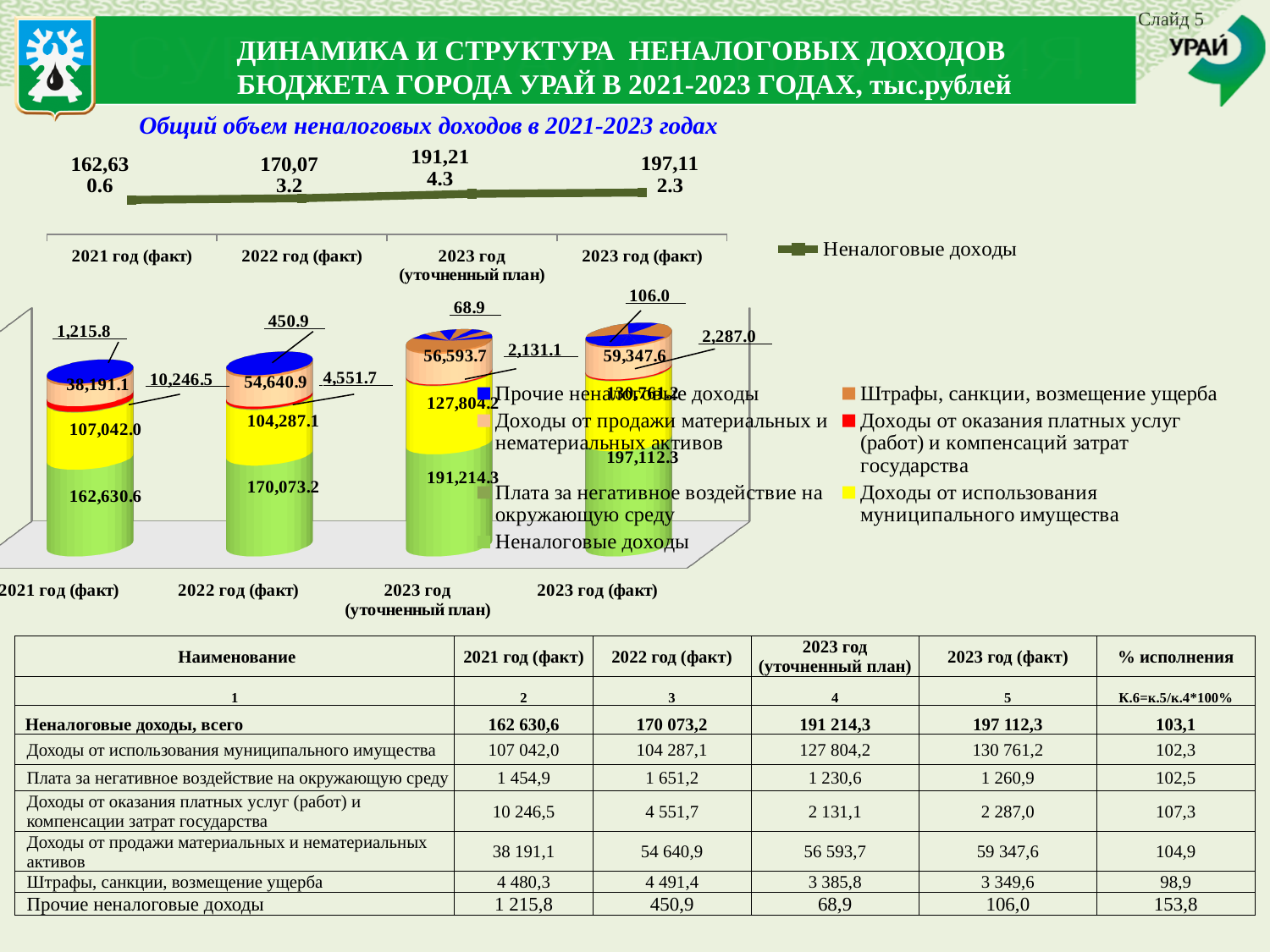
In the lower stacked chart, what is the difference between the Прочие неналоговые доходы values for 2021 год (факт) (1,215.8) and 2022 год (факт) (450.9)? 764.9 In the lower stacked chart, what is the labelled value of the top blue segment (Прочие неналоговые доходы) for 2021 год (факт)? 1,215.8 In the top chart 'Общий объем неналоговых доходов в 2021-2023 годах', what value is labelled for 2021 год (факт)? 162,630.6 In the lower stacked chart, what is the labelled value of the bottom green segment for 2022 год (факт)? 170,073.2 In the lower stacked chart, what is the labelled value of the yellow segment (Доходы от использования муниципального имущества) for 2023 год (уточненный план)? 127,804.2 In the top chart 'Общий объем неналоговых доходов в 2021-2023 годах', which category has the highest value? 2023 год (факт) In the lower stacked chart, which is larger: the Доходы от оказания платных услуг value for 2021 год (факт) (10,246.5) or for 2022 год (факт) (4,551.7)? 2021 год (факт) In the top chart 'Общий объем неналоговых доходов в 2021-2023 годах', what series name does the legend show? Неналоговые доходы In the top chart 'Общий объем неналоговых доходов в 2021-2023 годах', do the values rise or fall from 2021 год (факт) to 2023 год (факт)? rise In the lower stacked chart, how many series does the legend list? 7 In the top chart 'Общий объем неналоговых доходов в 2021-2023 годах', what value is labelled for 2023 год (факт)? 197,112.3 In the top chart 'Общий объем неналоговых доходов в 2021-2023 годах', how many categories are shown on the x axis? 4